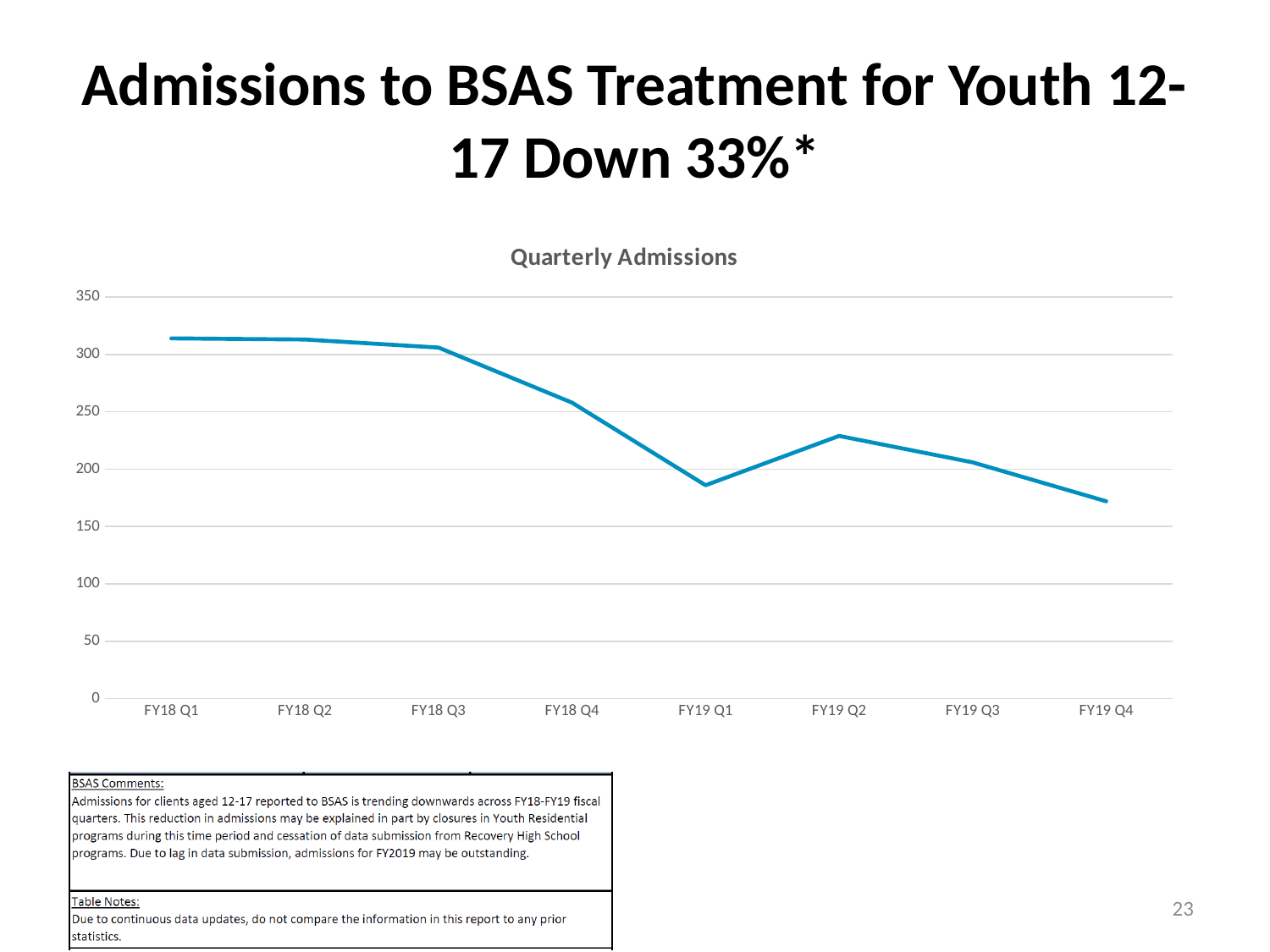
Is the value for FY19 Q2 greater or less than 200? greater Is the value for FY19 Q4 greater or less than 200? less Is the value for FY18 Q1 greater or less than 300? greater Which is larger, the value for FY19 Q2 or the value for FY19 Q3? FY19 Q2 How many quarters are plotted on the x axis? 8 Do the quarterly admissions generally rise or fall from FY18 Q1 to FY19 Q4? fall Which is larger, the value for FY18 Q1 or the value for FY19 Q4? FY18 Q1 Which is larger, the value for FY18 Q4 or the value for FY19 Q1? FY18 Q4 What is the title of the chart? Quarterly Admissions What kind of chart is shown on the slide? line chart